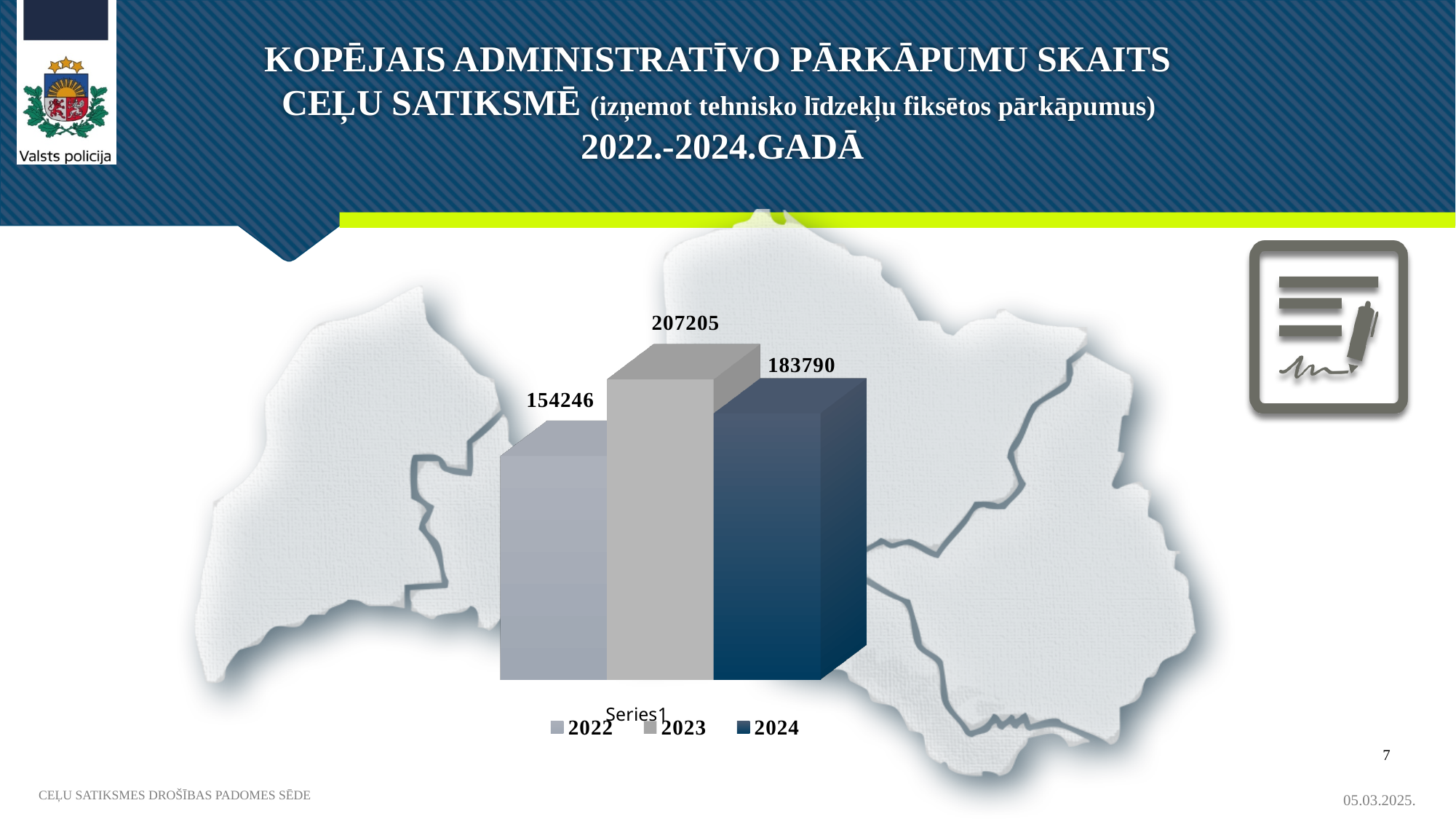
What is the difference between the values for 2023 and 2024? 23415 What is the value shown for 2023? 207205 What is the difference between the values for 2024 and 2022? 29544 Which year has the lowest value? 2022 What is the value shown for 2024? 183790 How many entries does the legend list? 3 What kind of chart is shown on the slide? bar chart What is the value shown for 2022? 154246 Which is larger, the value for 2024 or the value for 2022? 2024 How many bars are plotted in the chart? 3 Which year has the highest value? 2023 What is the difference between the values for 2023 and 2022? 52959